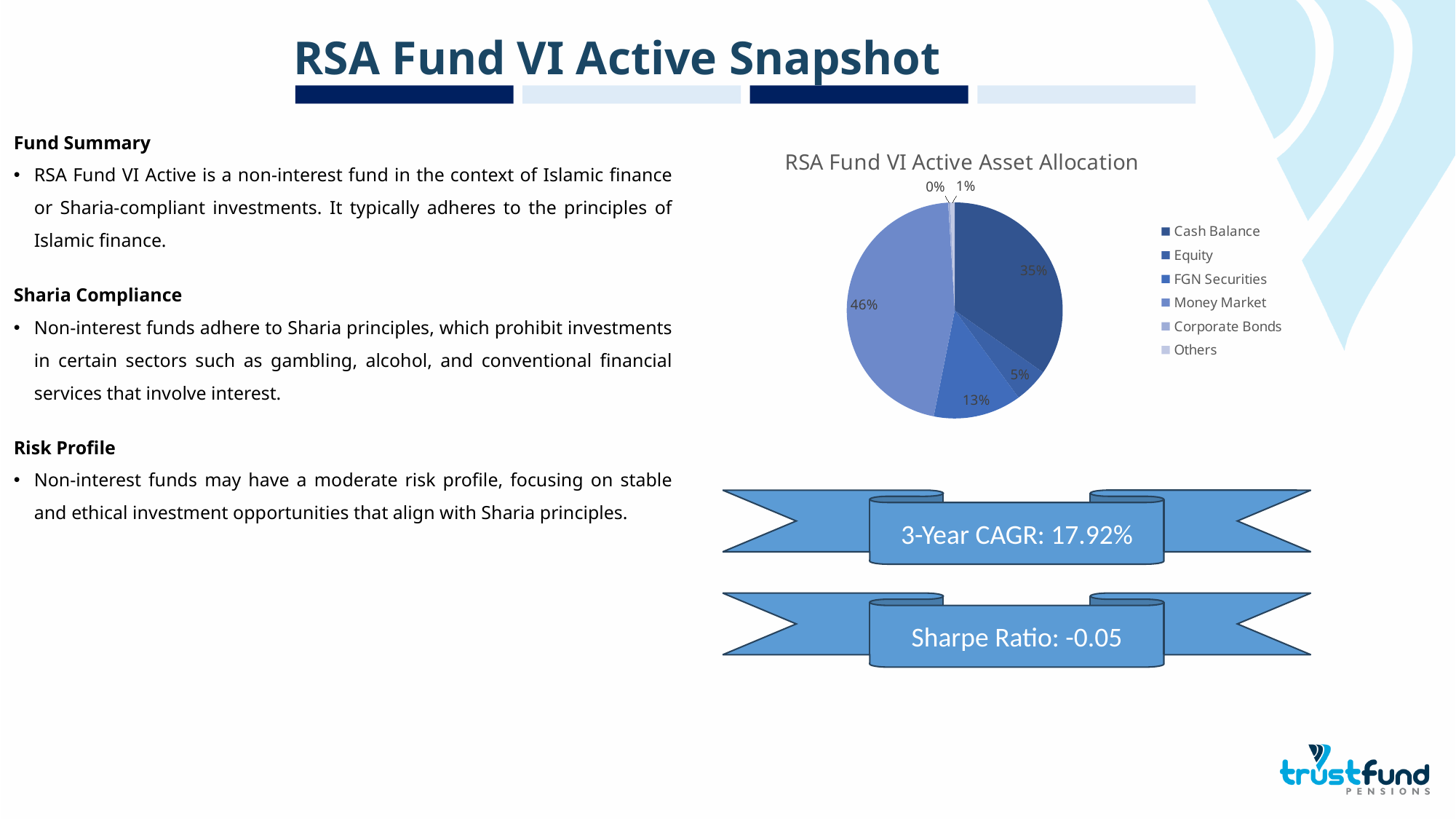
What share of the asset allocation is Equity? 5% What share of the asset allocation is Cash Balance? 35% What is the difference in percentage points between the Money Market and Cash Balance shares? 11 percentage points What share of the asset allocation is FGN Securities? 13% What type of chart is shown on the slide? Pie chart What is the title of the chart? RSA Fund VI Active Asset Allocation Which has a larger share of the allocation, FGN Securities or Equity? FGN Securities Which asset class has the largest share of the allocation? Money Market What share of the asset allocation is Others? 1% Which asset class has the smallest share of the allocation? Corporate Bonds How many categories does the legend of the pie chart list? 6 What share of the asset allocation is Money Market? 46%